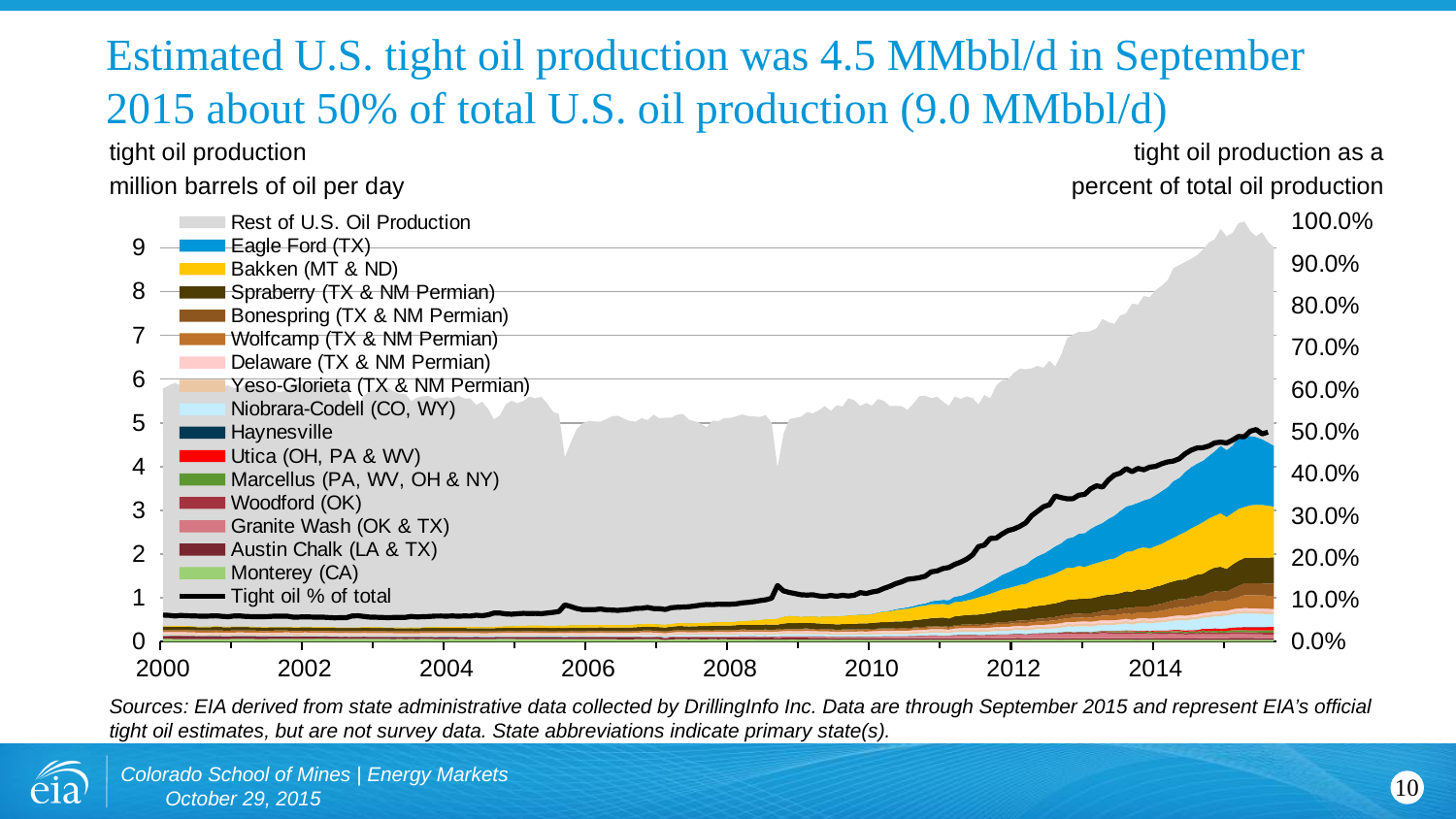
In 2015, which tight oil play contributes more production, Eagle Ford (TX) or Bakken (MT & ND)? Eagle Ford (TX) Is the 'Tight oil % of total' value in 2008 greater or less than 20.0%? less Does the 'Tight oil % of total' line rise or fall between 2010 and 2015? rise What is the unit of the left-hand axis of the chart? million barrels of oil per day Is the 'Tight oil % of total' value at the end of 2015 greater or less than 40.0%? greater According to the slide title, what was estimated U.S. tight oil production in September 2015? 4.5 MMbbl/d How many entries does the chart legend list? 17 According to the slide title, what was total U.S. oil production in September 2015? 9.0 MMbbl/d Is total U.S. oil production (top of the stacked area) in 2000 greater or less than 7 million barrels per day? less What kind of chart is shown on the slide? stacked area chart with a line What does the right-hand axis of the chart measure? tight oil production as a percent of total oil production